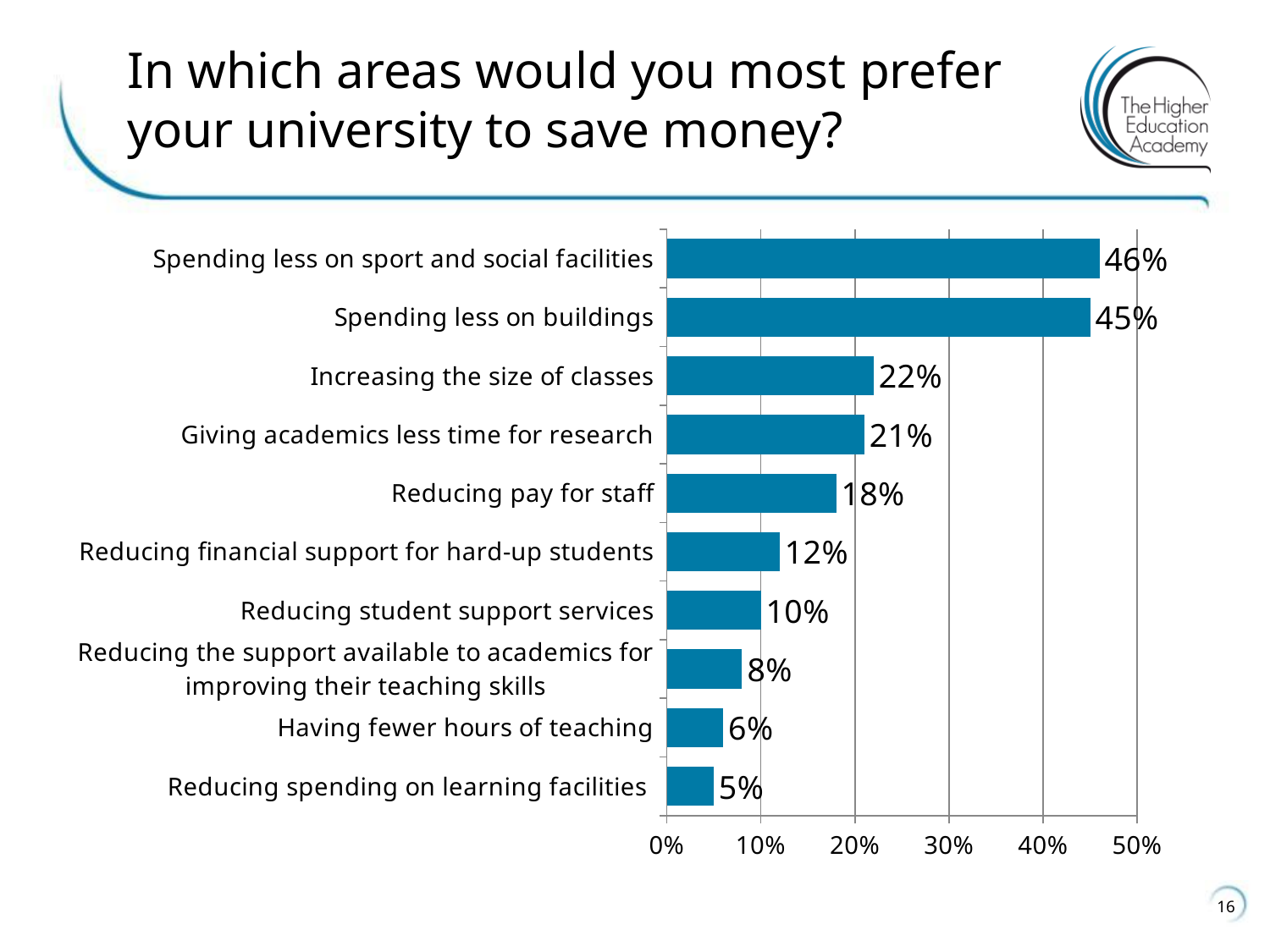
How many areas are shown in the chart? 10 What percentage of respondents chose 'Spending less on buildings'? 45% What is the difference between 'Increasing the size of classes' and 'Reducing student support services'? 12% What type of chart is shown on the slide? Bar chart What is the difference between 'Spending less on sport and social facilities' and 'Reducing pay for staff'? 28% What is the value for 'Reducing pay for staff'? 18% Which area has the lowest percentage? Reducing spending on learning facilities Is the value for 'Giving academics less time for research' greater or less than 30%? less What is the maximum value shown on the horizontal axis? 50% What percentage is shown for 'Reducing the support available to academics for improving their teaching skills'? 8% Which is larger: 'Reducing financial support for hard-up students' or 'Having fewer hours of teaching'? Reducing financial support for hard-up students Which area has the highest percentage? Spending less on sport and social facilities